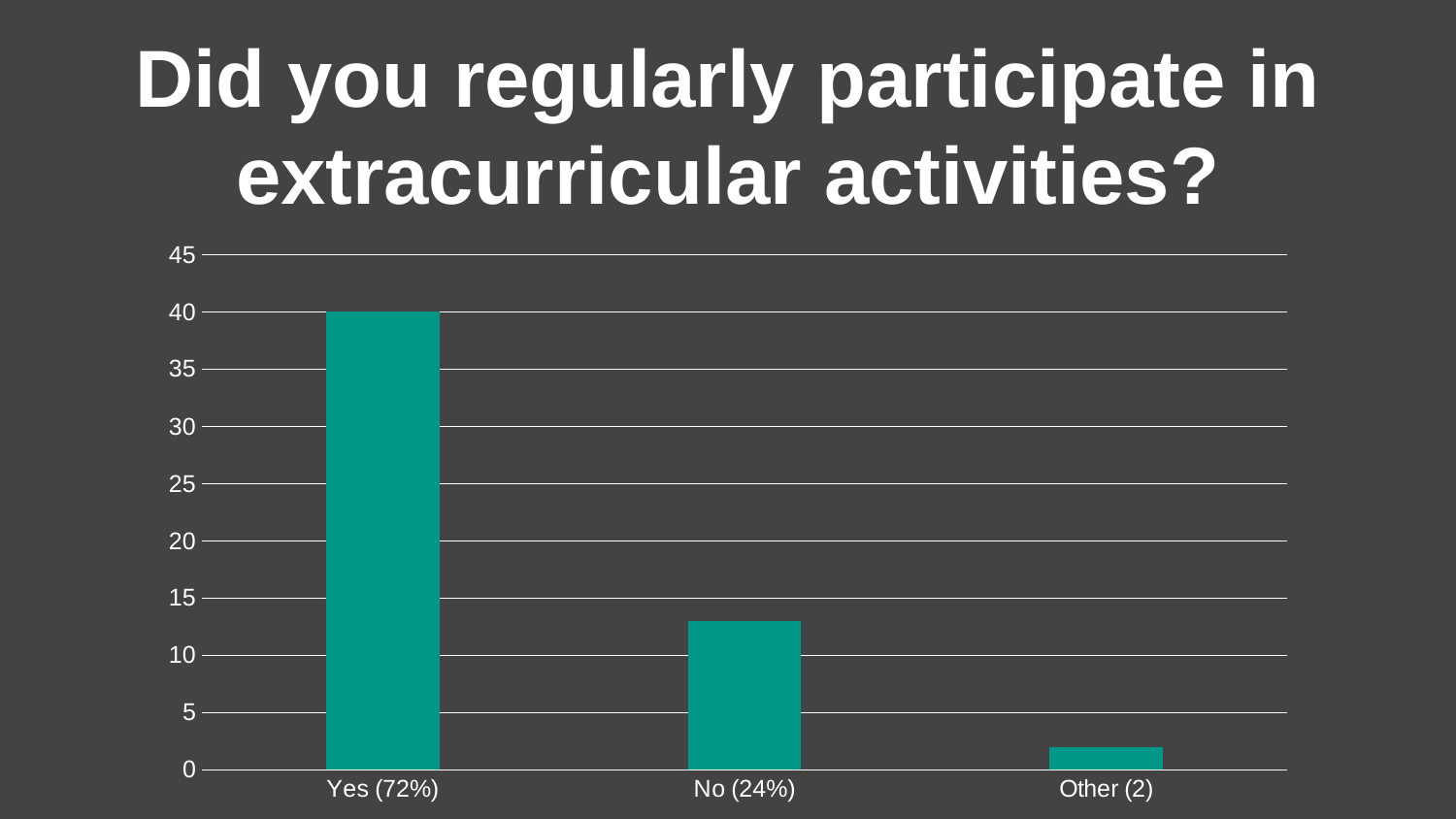
Is the value for No (24%) greater or less than 15? less Is the value for No (24%) greater or less than 10? greater What kind of chart is shown on the slide? bar chart Do the bar values rise or fall from left to right along the x axis? fall Is the value for Other (2) greater or less than 5? less What is the title of the slide? Did you regularly participate in extracurricular activities? Which category has the highest bar? Yes (72%) Which is larger, the bar for Yes (72%) or the bar for No (24%)? Yes (72%) What is the highest value shown on the y axis? 45 How many categories are shown on the x axis? 3 Which category has the lowest bar? Other (2) What value does the bar for Yes (72%) reach on the y axis? 40